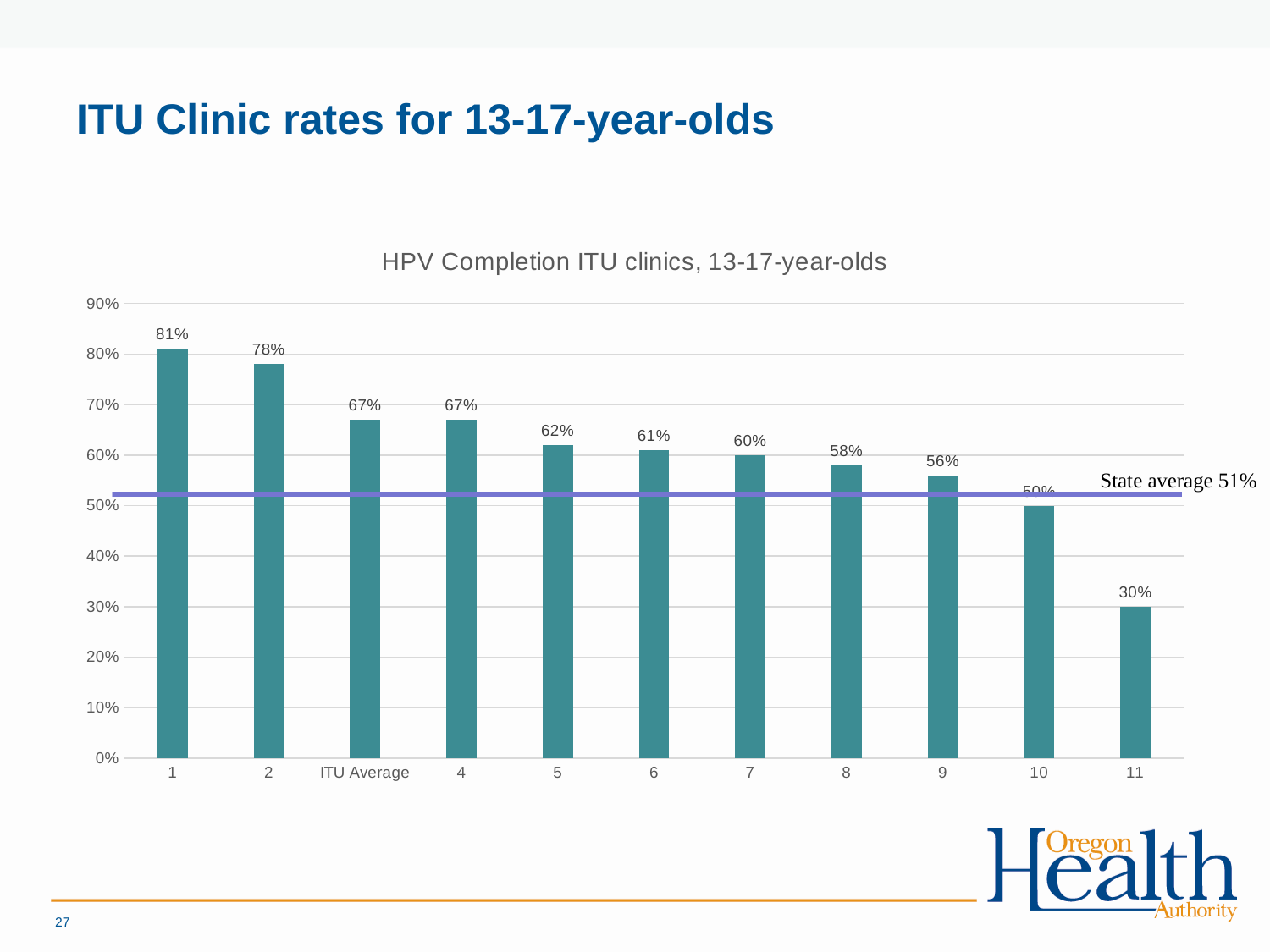
Is the value for clinic 10 greater or less than 60%? less Which is larger, the value for clinic 5 or the value for clinic 8? Clinic 5 What is the value for the ITU Average bar? 67% What state average value is labelled on the horizontal line across the chart? 51% What is the value for clinic 11? 30% What kind of chart is shown on the slide? Bar chart How many bars are plotted in the chart? 11 Which category has the lowest value? 11 Which category has the highest value? 1 What is the value for clinic 2? 78% What is the difference between the values for clinic 1 and clinic 11? 51% What is the value for clinic 1? 81%